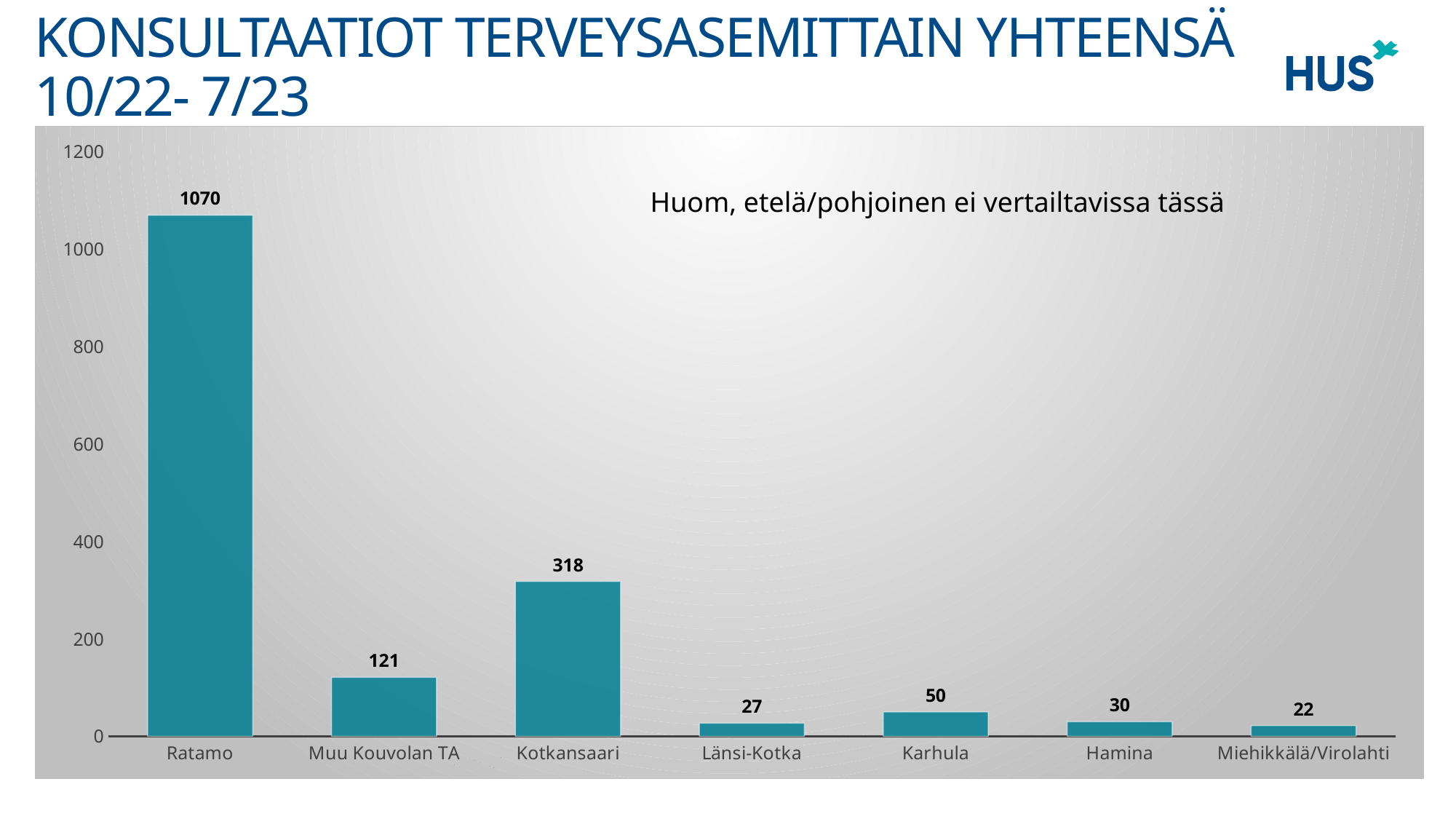
What is the value for Muu Kouvolan TA? 121 Which category has the lowest value? Miehikkälä/Virolahti What is the difference between the values for Karhula and Hamina? 20 What is the value for Ratamo? 1070 What note is written inside the chart area? Huom, etelä/pohjoinen ei vertailtavissa tässä What is the value for Kotkansaari? 318 Which category has the highest value? Ratamo What kind of chart is shown on the slide? Bar chart What is the value for Miehikkälä/Virolahti? 22 How many categories are shown on the x axis? 7 Which is larger, the value for Länsi-Kotka or the value for Hamina? Hamina What is the difference between the values for Ratamo and Kotkansaari? 752